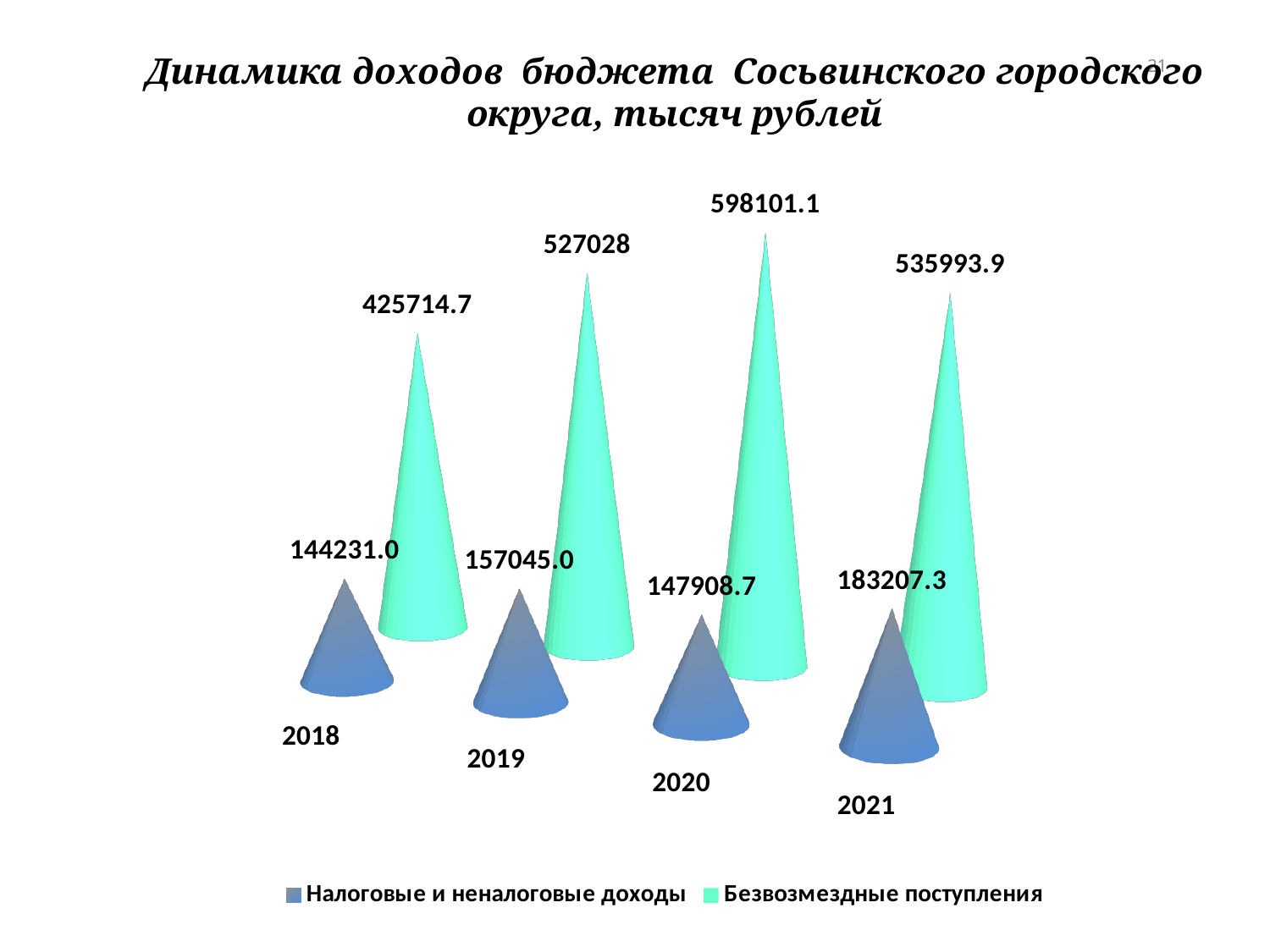
Which is larger: Безвозмездные поступления in 2021 or in 2019? 2021 What is the value of Налоговые и неналоговые доходы for 2018? 144231.0 What is the difference between Безвозмездные поступления in 2020 and in 2019? 71073.1 In which year is Налоговые и неналоговые доходы lowest? 2018 What is the value of Безвозмездные поступления for 2020? 598101.1 How many series does the legend list? 2 What is the difference between Налоговые и неналоговые доходы in 2021 and in 2018? 38976.3 In which year is Безвозмездные поступления highest? 2020 What is the value of Безвозмездные поступления for 2019? 527028 What is the value of Налоговые и неналоговые доходы for 2021? 183207.3 What kind of chart is shown on the slide? Bar chart (3D cone bars) How many years are shown on the x axis? 4